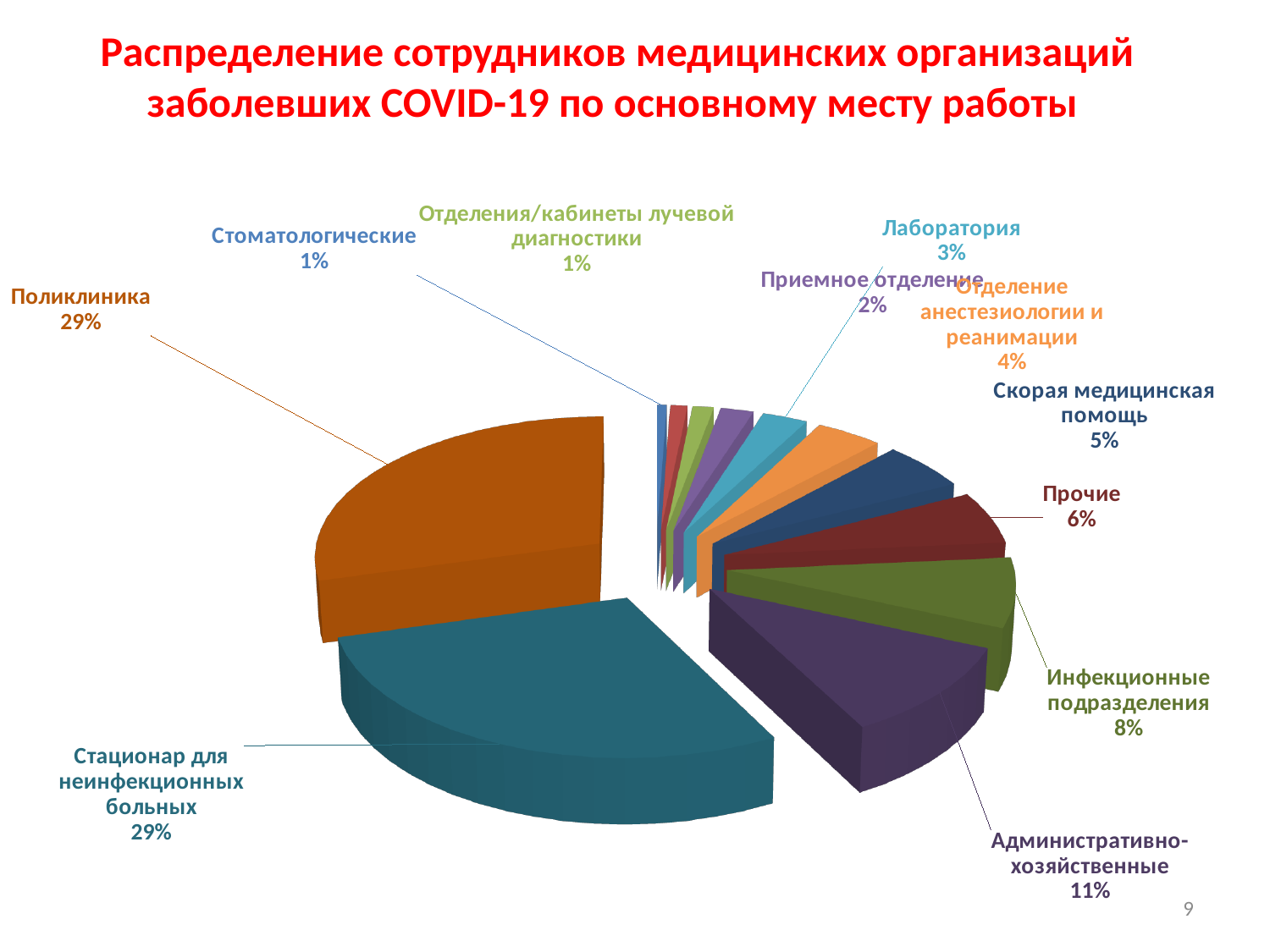
Which has a larger share: Стационар для неинфекционных больных or Административно-хозяйственные? Стационар для неинфекционных больных What type of chart is shown on the slide? Pie chart What is the difference in percentage points between Административно-хозяйственные and Инфекционные подразделения? 3 What share is labelled for Инфекционные подразделения? 8% What share does Лаборатория have in the pie chart? 3% How many categories are shown in the pie chart? 12 What share of the pie does Поликлиника account for? 29% What percentage is shown for Скорая медицинская помощь? 5% What is the title of the slide? Распределение сотрудников медицинских организаций заболевших COVID-19 по основному месту работы What percentage is labelled for Приемное отделение? 2% What percentage is shown for Административно-хозяйственные? 11% Which has a larger share: Прочие or Отделение анестезиологии и реанимации? Прочие